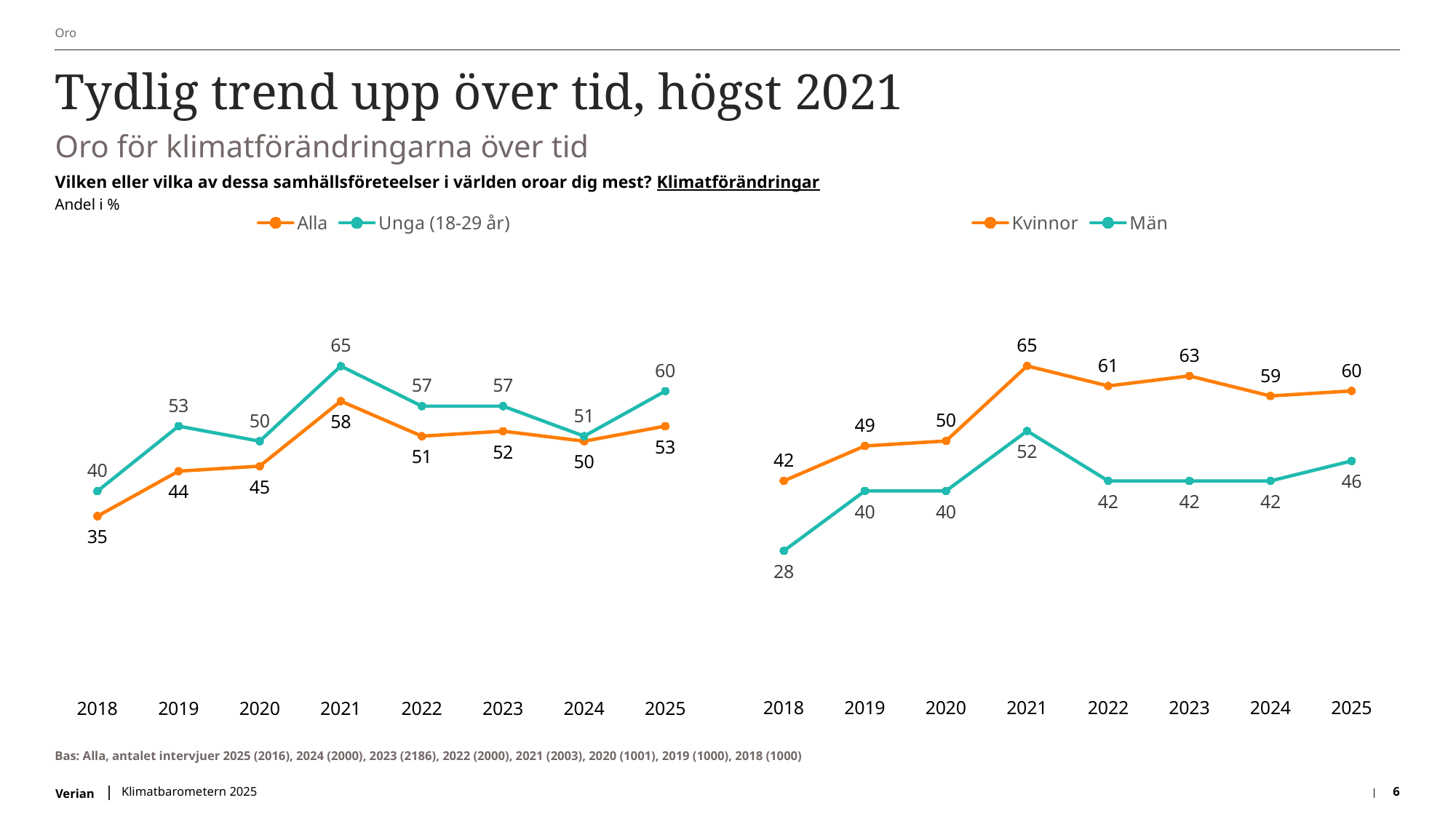
In the left chart (Alla / Unga), in which year does Unga (18-29 år) reach its highest value? 2021 In the right chart (Kvinnor / Män), what is the value for Kvinnor in 2023? 63 In the right chart (Kvinnor / Män), what is the difference between Kvinnor and Män in 2023? 21 In the left chart (Alla / Unga), what is the value for Unga (18-29 år) in 2025? 60 In the left chart (Alla / Unga), what is the difference between Unga (18-29 år) and Alla in 2021? 7 In the left chart (Alla / Unga), which series has the higher value in 2024, Alla or Unga (18-29 år)? Unga (18-29 år) In the right chart (Kvinnor / Män), what is the value for Män in 2018? 28 In the right chart (Kvinnor / Män), in which year is the value for Män lowest? 2018 In the left chart (Alla / Unga), what is the value for Alla in 2018? 35 How many years are shown on the x axis of the right chart (Kvinnor / Män)? 8 What kind of chart is the left chart (Alla / Unga)? Line chart How many series does the legend of the left chart list? 2